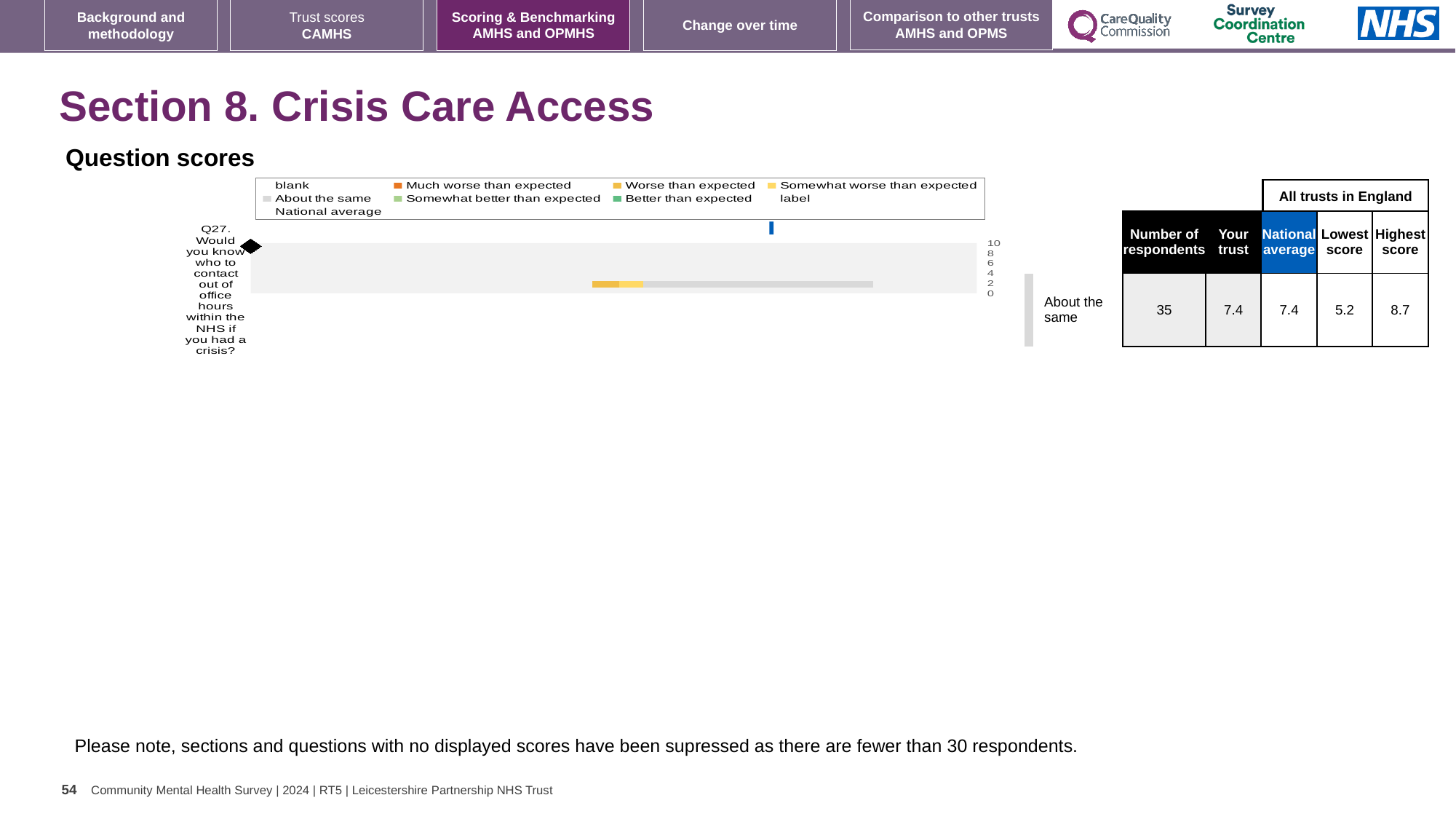
What is the maximum value shown on the score axis of the question scores chart? 10 How many respondents answered Q27? 35 What is the lowest score among all trusts in England for Q27? 5.2 What is the highest score among all trusts in England for Q27? 8.7 What kind of chart is used to show the question scores on this slide? bar chart How many survey questions are plotted in the question scores chart? 1 Is the trust's score for Q27 higher or lower than the national average, or the same? the same Which question is plotted in the question scores chart? Q27. Would you know who to contact out of office hours within the NHS if you had a crisis? What is the national average score for Q27 shown beside the chart? 7.4 What benchmark category is shown next to the chart for Q27? About the same What is the 'Your trust' score for Q27 shown beside the chart? 7.4 What is the difference between the highest score and the lowest score for Q27 across all trusts in England? 3.5